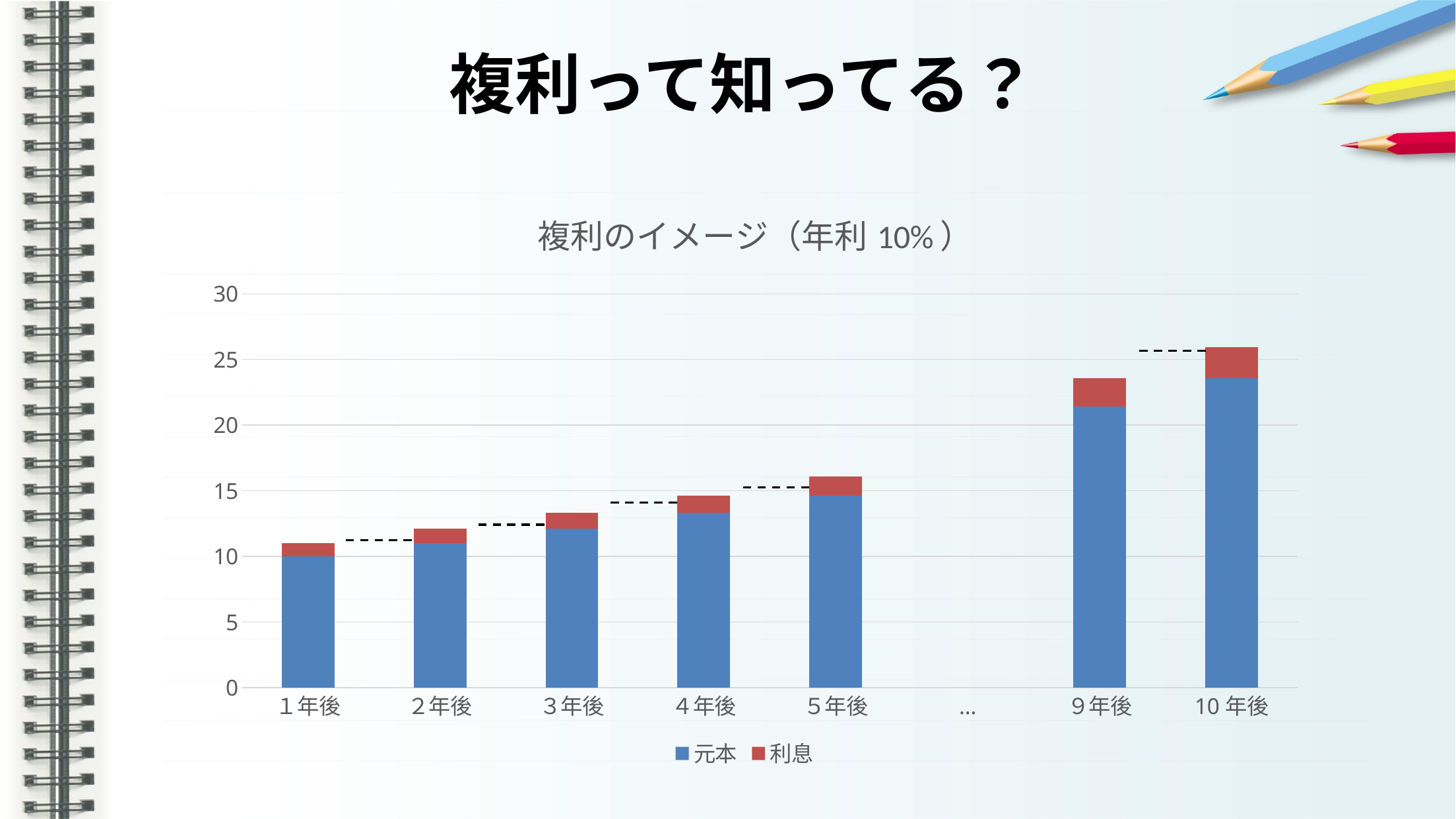
Which series is shown in blue? 元本 Which category has the shortest stacked bar? 1年後 Is the total stacked bar for 5年後 greater or less than 15? greater Do the stacked bar totals rise or fall from 1年後 to 10年後? rise How many bars are plotted in the chart? 7 Is the total stacked bar for 10年後 greater or less than 25? greater What kind of chart is shown on the slide? bar chart Which has a taller stacked bar, 5年後 or 9年後? 9年後 Is the total stacked bar for 9年後 greater or less than 25? less Which category has the tallest stacked bar? 10年後 How many series does the legend list? 2 What is the title of the chart? 複利のイメージ（年利 10%）